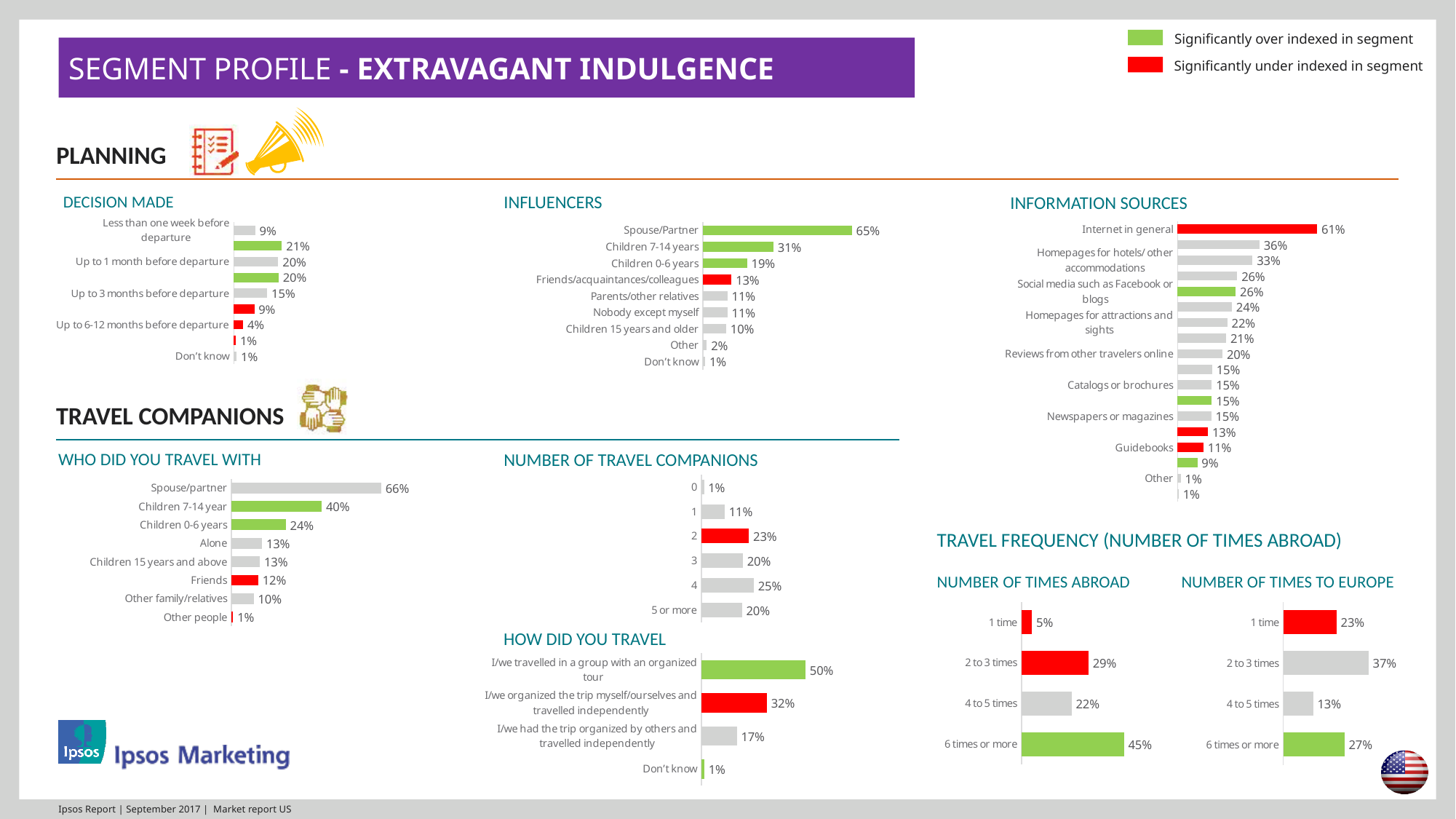
In the NUMBER OF TIMES ABROAD chart, what is the difference between 6 times or more and 1 time? 40 percentage points In the INFLUENCERS chart, which category has the highest value? Spouse/Partner In the HOW DID YOU TRAVEL chart, what is the value for 'I/we travelled in a group with an organized tour'? 50% In the INFLUENCERS chart, what is the value for Spouse/Partner? 65% In the INFORMATION SOURCES chart, what is the value for Internet in general? 61% In the WHO DID YOU TRAVEL WITH chart, what is the value for Friends? 12% How many categories are shown in the NUMBER OF TRAVEL COMPANIONS chart? 6 In the NUMBER OF TRAVEL COMPANIONS chart, which category has the highest value? 4 In the WHO DID YOU TRAVEL WITH chart, which is larger: Children 7-14 year or Children 0-6 years? Children 7-14 year What type of chart is the INFLUENCERS chart? Bar chart In the NUMBER OF TIMES ABROAD chart, what is the value for 6 times or more? 45% In the NUMBER OF TIMES TO EUROPE chart, which category has the highest value? 2 to 3 times